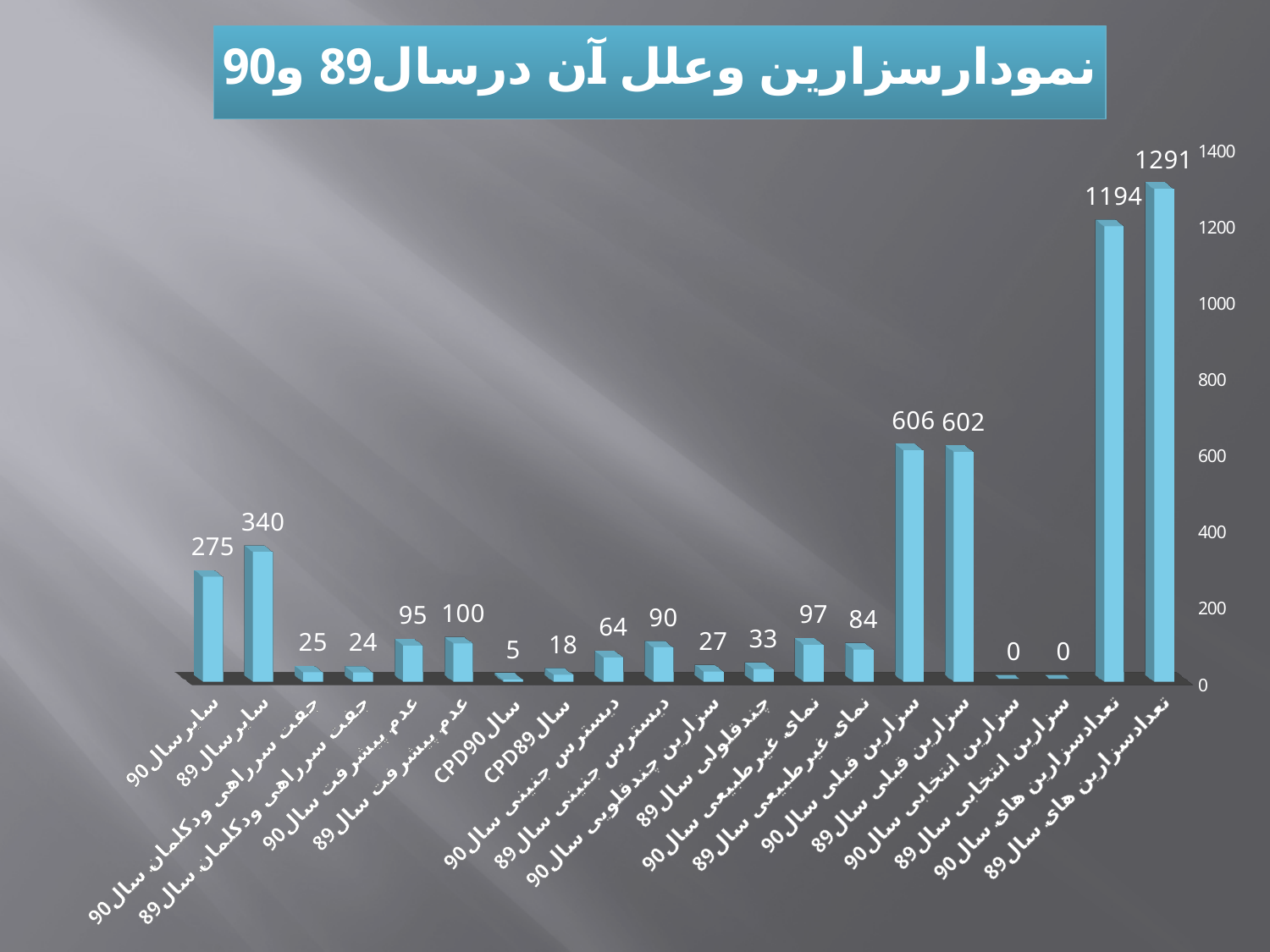
Which category has the highest value? تعدادسزارین های سال89 What is the difference between سایرسال89 and سایرسال90? 65 What is the value for سزارین قبلی سال90? 606 Which is larger, نمای غیرطبیعی سال90 or نمای غیرطبیعی سال89? نمای غیرطبیعی سال90 What is the value for سال CPD90? 5 What kind of chart is shown on the slide? bar chart Which is larger, دیسترس جنینی سال89 or دیسترس جنینی سال90? دیسترس جنینی سال89 How many categories are shown on the chart? 20 What is the value for سایرسال89? 340 What is the difference between تعدادسزارین های سال89 and تعدادسزارین های سال90? 97 What is the value for تعدادسزارین های سال89? 1291 What is the value for سزارین انتخابی سال89? 0